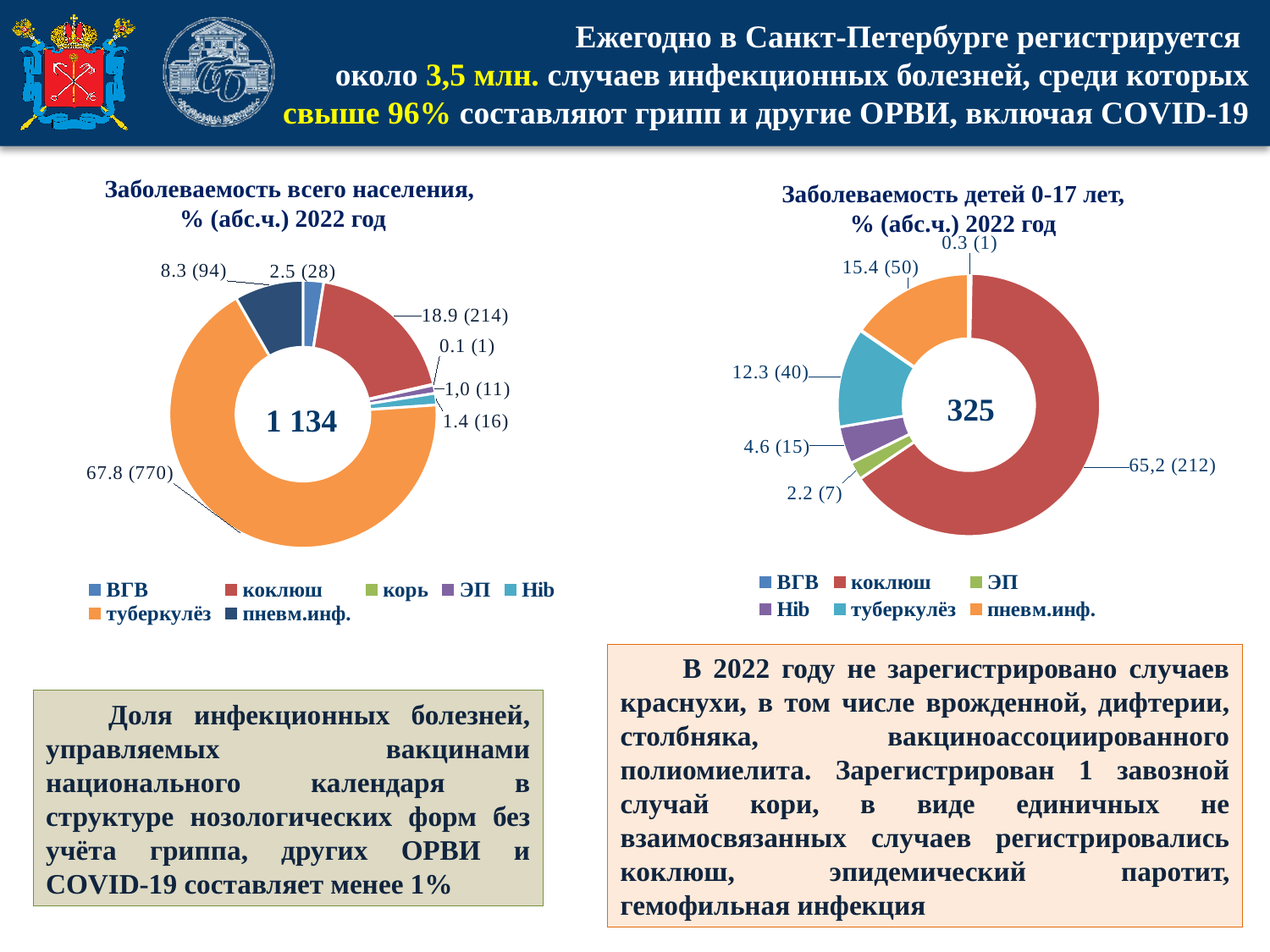
On the chart 'Заболеваемость всего населения, % (абс.ч.) 2022 год', what is the label on the largest slice? 67.8 (770) On the chart 'Заболеваемость детей 0-17 лет, % (абс.ч.) 2022 год', how many categories does the legend list? 6 On the chart 'Заболеваемость детей 0-17 лет, % (абс.ч.) 2022 год', which category has the largest share? коклюш On the chart 'Заболеваемость детей 0-17 лет, % (абс.ч.) 2022 год', what total number is shown in the centre of the donut? 325 On the chart 'Заболеваемость всего населения, % (абс.ч.) 2022 год', what kind of chart is shown? Pie (donut) chart On the chart 'Заболеваемость всего населения, % (абс.ч.) 2022 год', which category has the largest share? туберкулёз On the chart 'Заболеваемость детей 0-17 лет, % (абс.ч.) 2022 год', what is the label on the largest slice? 65,2 (212) On the chart 'Заболеваемость всего населения, % (абс.ч.) 2022 год', how many categories does the legend list? 7 On the chart 'Заболеваемость детей 0-17 лет, % (абс.ч.) 2022 год', which is larger: the share for туберкулёз or the share for пневм.инф.? пневм.инф. On the chart 'Заболеваемость всего населения, % (абс.ч.) 2022 год', which category has the smallest share? корь On the chart 'Заболеваемость всего населения, % (абс.ч.) 2022 год', what total number is shown in the centre of the donut? 1 134 On the chart 'Заболеваемость всего населения, % (абс.ч.) 2022 год', what is the label on the коклюш slice? 18.9 (214)